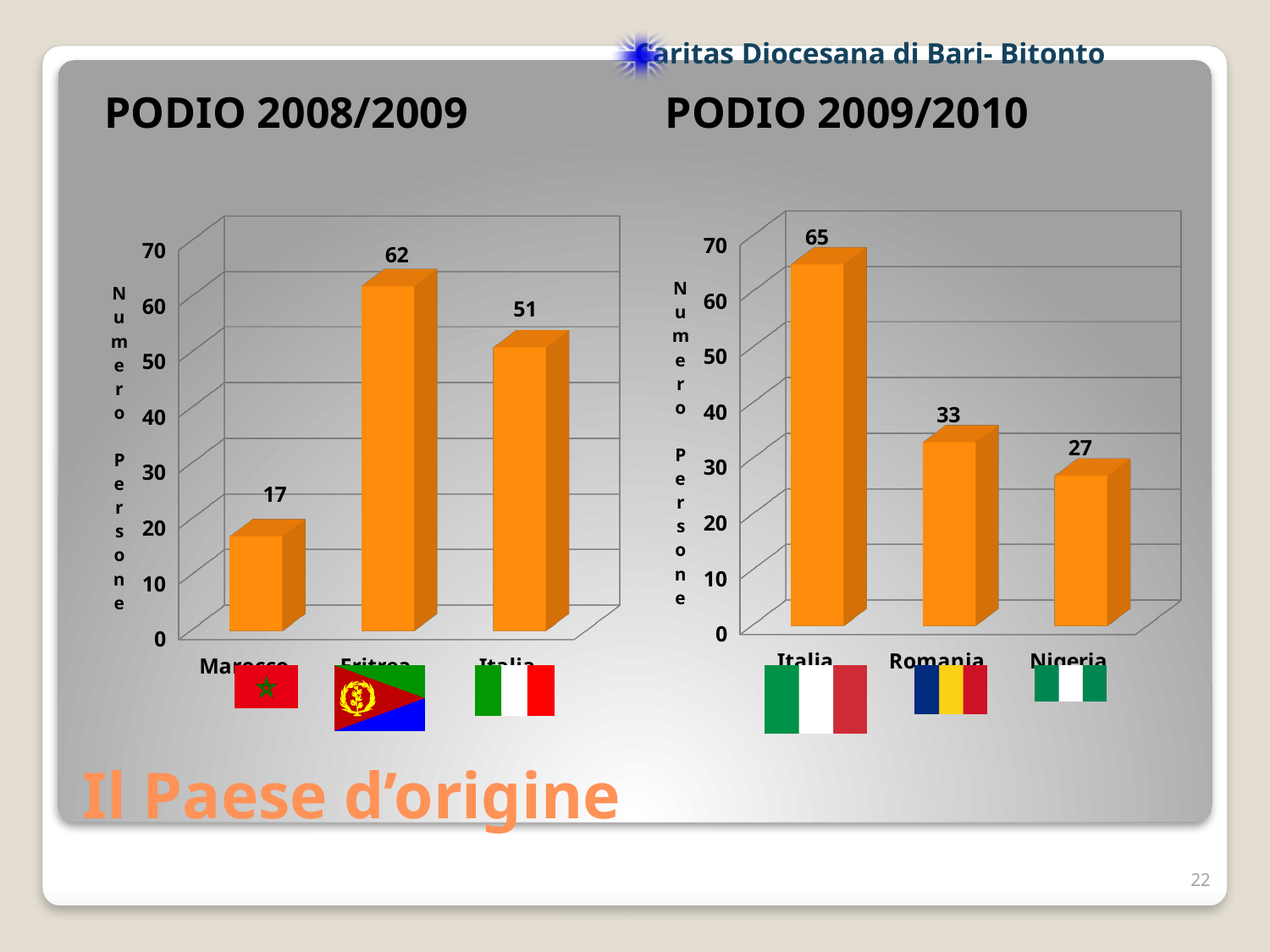
In the PODIO 2009/2010 chart, do the values rise or fall from left to right along the x axis? fall In the PODIO 2008/2009 chart, which category has the lowest value? Marocco In the PODIO 2008/2009 chart, what is the value for Eritrea? 62 What is the y-axis label of the PODIO 2008/2009 chart? Numero Persone In the PODIO 2009/2010 chart, which category has the highest value? Italia In the PODIO 2009/2010 chart, which is larger, the value for Romania or the value for Nigeria? Romania In the PODIO 2009/2010 chart, what is the value for Romania? 33 In the PODIO 2008/2009 chart, what is the value for Marocco? 17 What kind of chart is the PODIO 2009/2010 chart? bar chart In the PODIO 2008/2009 chart, what is the difference between the values for Eritrea and Italia? 11 In the PODIO 2008/2009 chart, how many categories are shown? 3 In the PODIO 2009/2010 chart, what is the difference between the values for Italia and Nigeria? 38